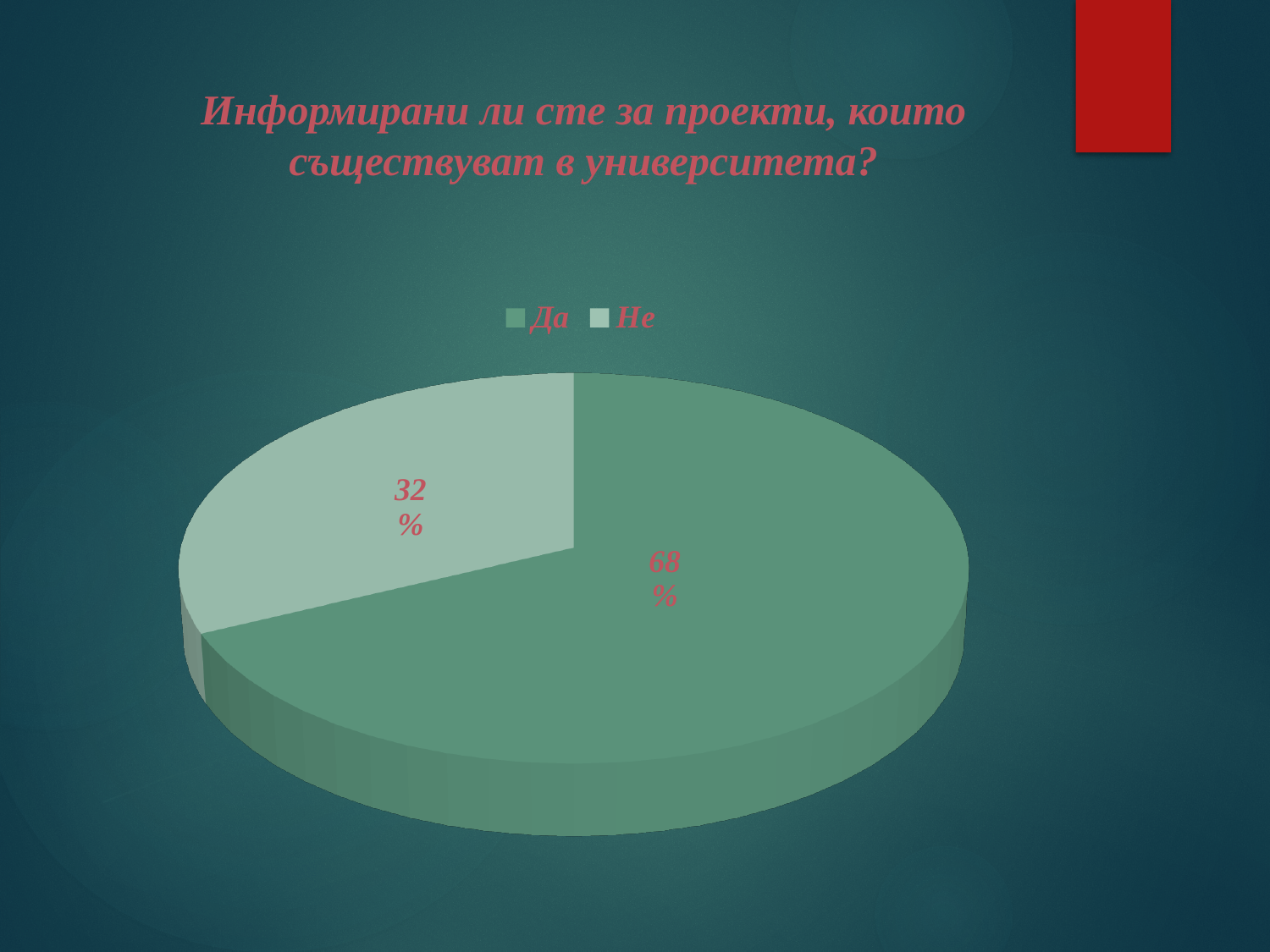
How many slices does the pie chart have? 2 What is the difference in percentage points between the "Да" and "Не" slices? 36 What kind of chart is shown on the slide? pie chart Which answer has the smallest share of the pie? Не What percentage of respondents answered "Не"? 32% How many entries does the legend list? 2 What is the title of the chart on the slide? Информирани ли сте за проекти, които съществуват в университета? What share of the pie does the "Не" slice represent? 32% What percentage of respondents answered "Да"? 68% Which legend entry is shown in the lighter green colour? Не Which slice is larger, "Да" or "Не"? Да Which answer has the largest share of the pie? Да